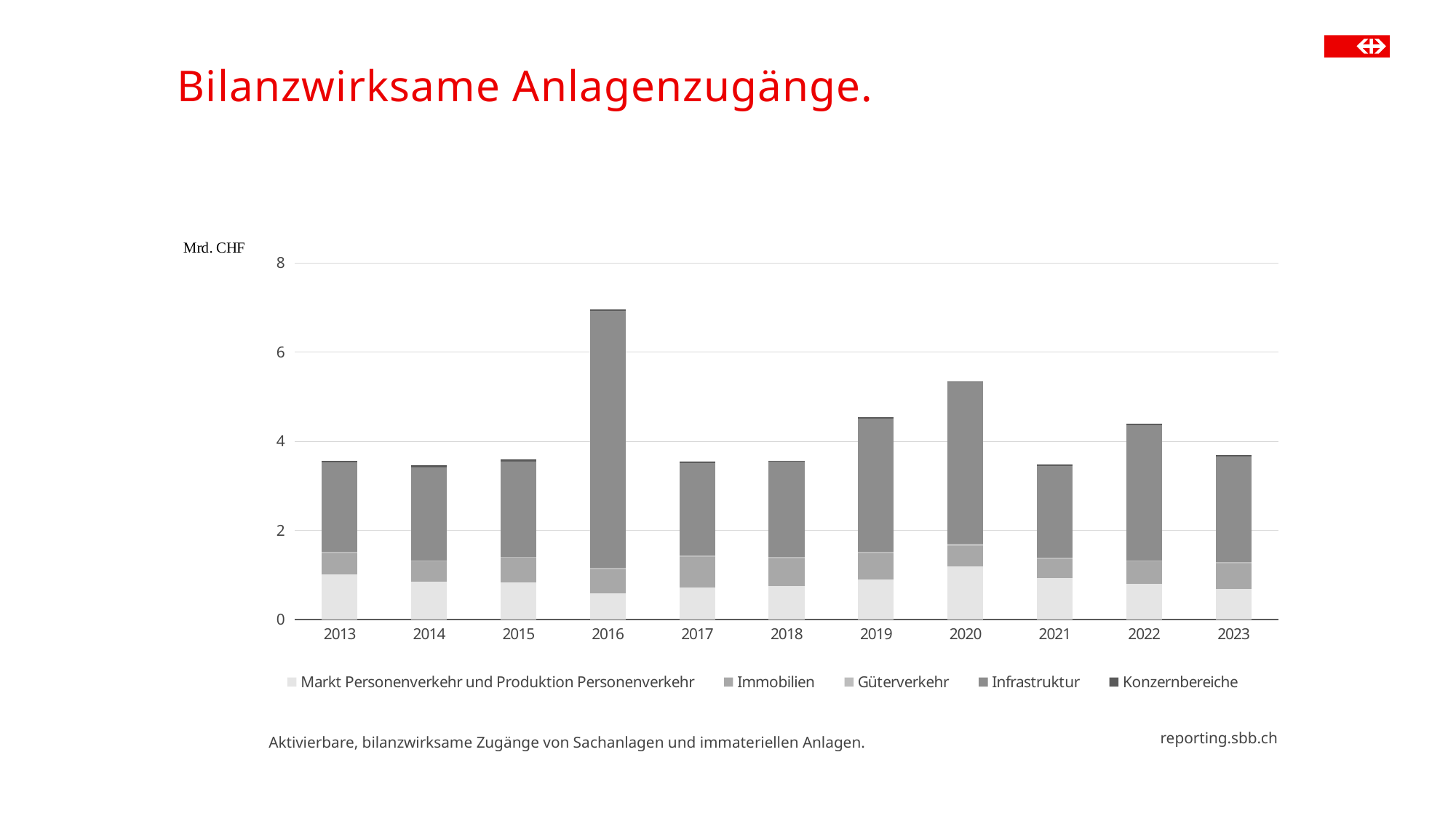
What is the title of the slide? Bilanzwirksame Anlagenzugänge. Is the total value for 2020 greater or less than 4? greater How many series does the chart's legend list? 5 Which year has the larger total bar, 2019 or 2021? 2019 Which year has the highest total bar in the chart? 2016 How many years are shown on the x axis of the chart? 11 What unit is shown on the y axis of the chart? Mrd. CHF Is the total value for 2023 greater or less than 4? less Which year has the larger total bar, 2016 or 2020? 2016 What kind of chart is shown on the slide? Stacked bar chart Is the total value for 2013 greater or less than 4? less